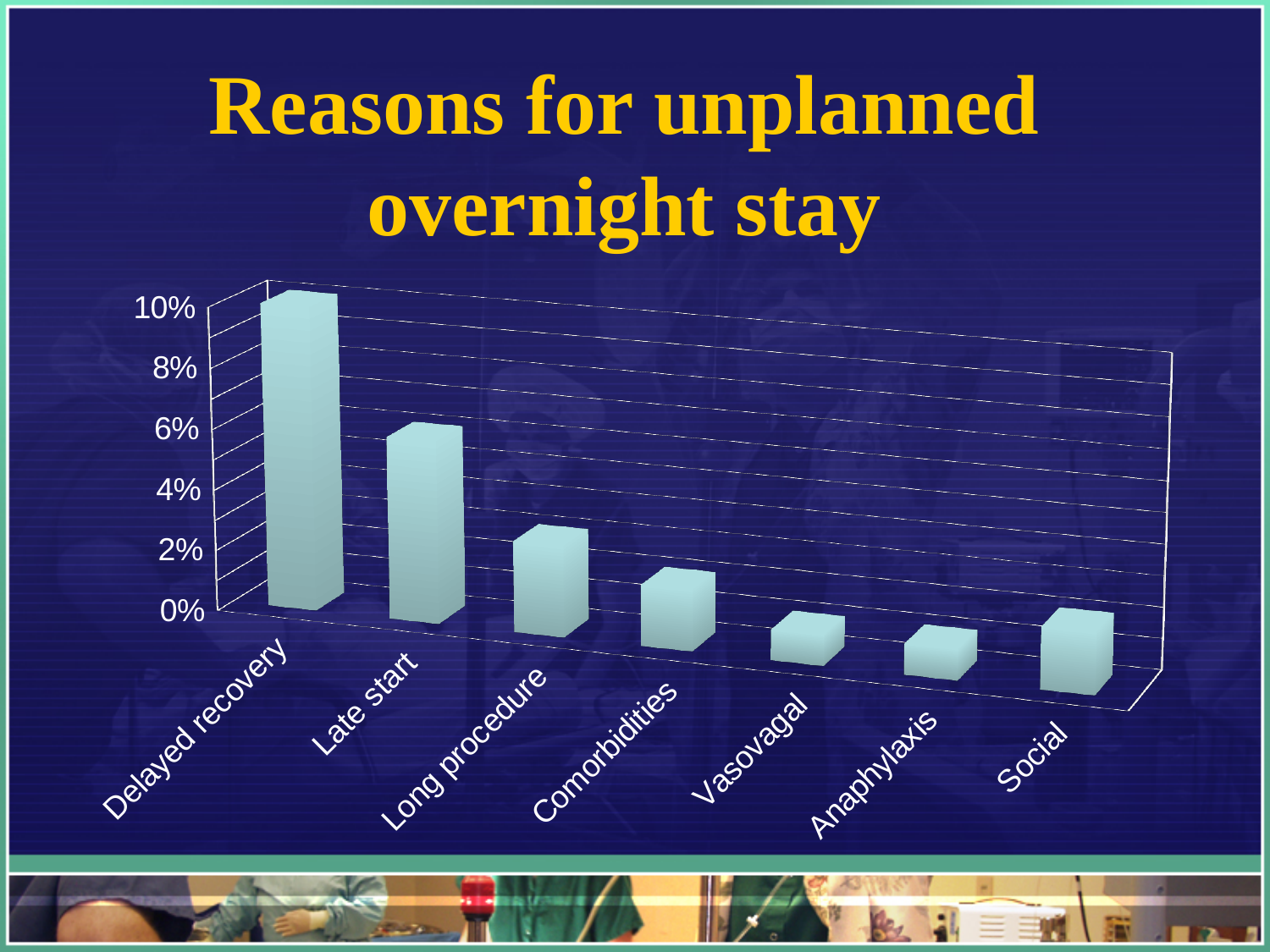
What type of chart is shown on the slide? bar chart Which reason has the highest value? Delayed recovery Is the value for Late start greater or less than 4%? greater Which is larger, the value for Delayed recovery or the value for Social? Delayed recovery What is the title of the chart? Reasons for unplanned overnight stay Is the value for Long procedure greater or less than 4%? less Is the value for Delayed recovery greater or less than 8%? greater From Delayed recovery to Anaphylaxis, do the values rise or fall along the x axis? fall Which is larger, the value for Late start or the value for Long procedure? Late start How many reasons (categories) are plotted on the chart? 7